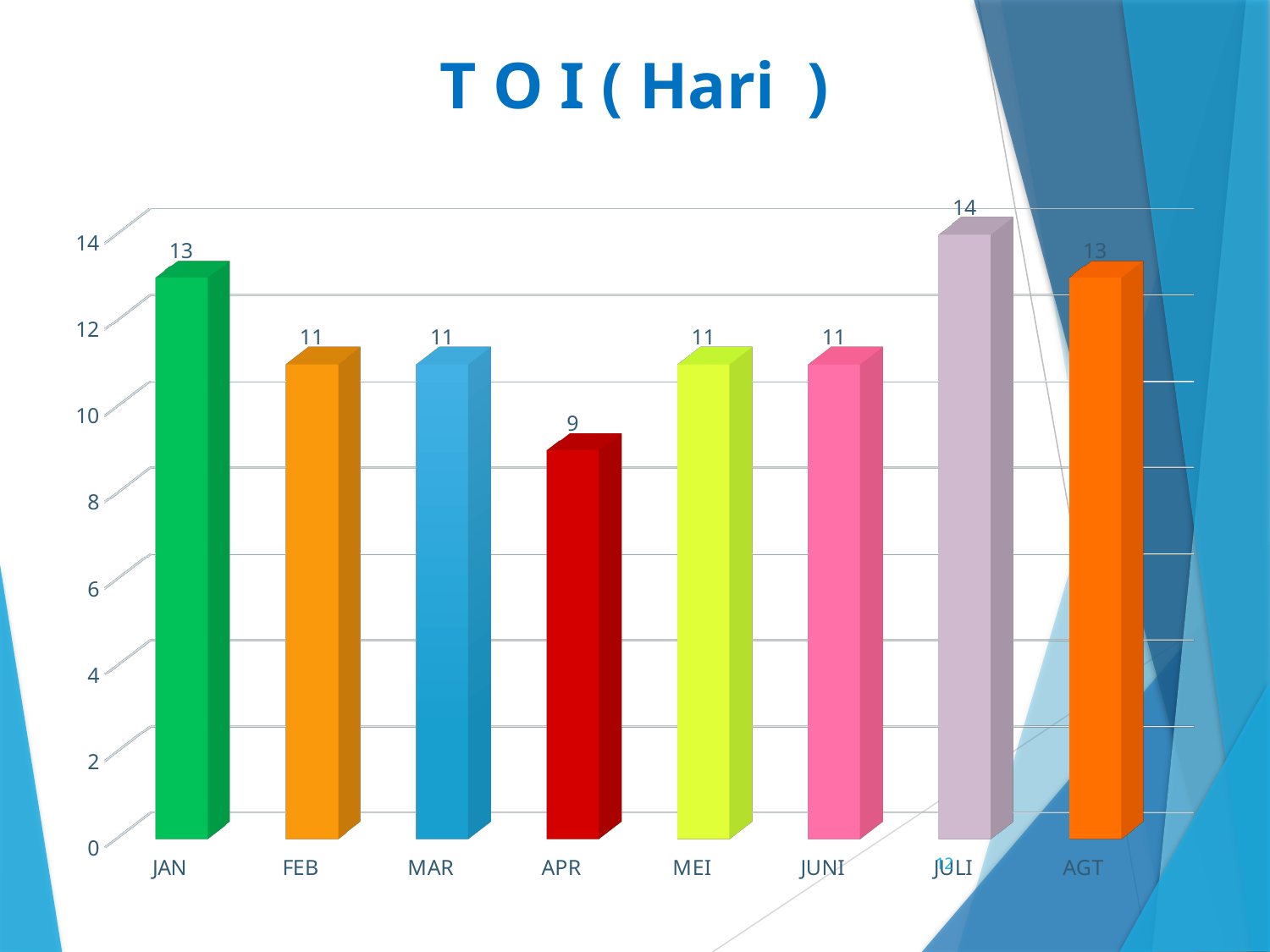
Is the value for APR greater or less than 10? less What is the value for AGT? 13 Which is larger, the value for JAN or the value for FEB? JAN What is the value for APR? 9 What is the value for JAN? 13 What is the difference between the values for JULI and APR? 5 What is the title of the chart? T O I ( Hari ) How many months are shown on the x axis? 8 What is the value for JULI? 14 Which month has the highest value? JULI What kind of chart is shown on the slide? bar chart Which month has the lowest value? APR